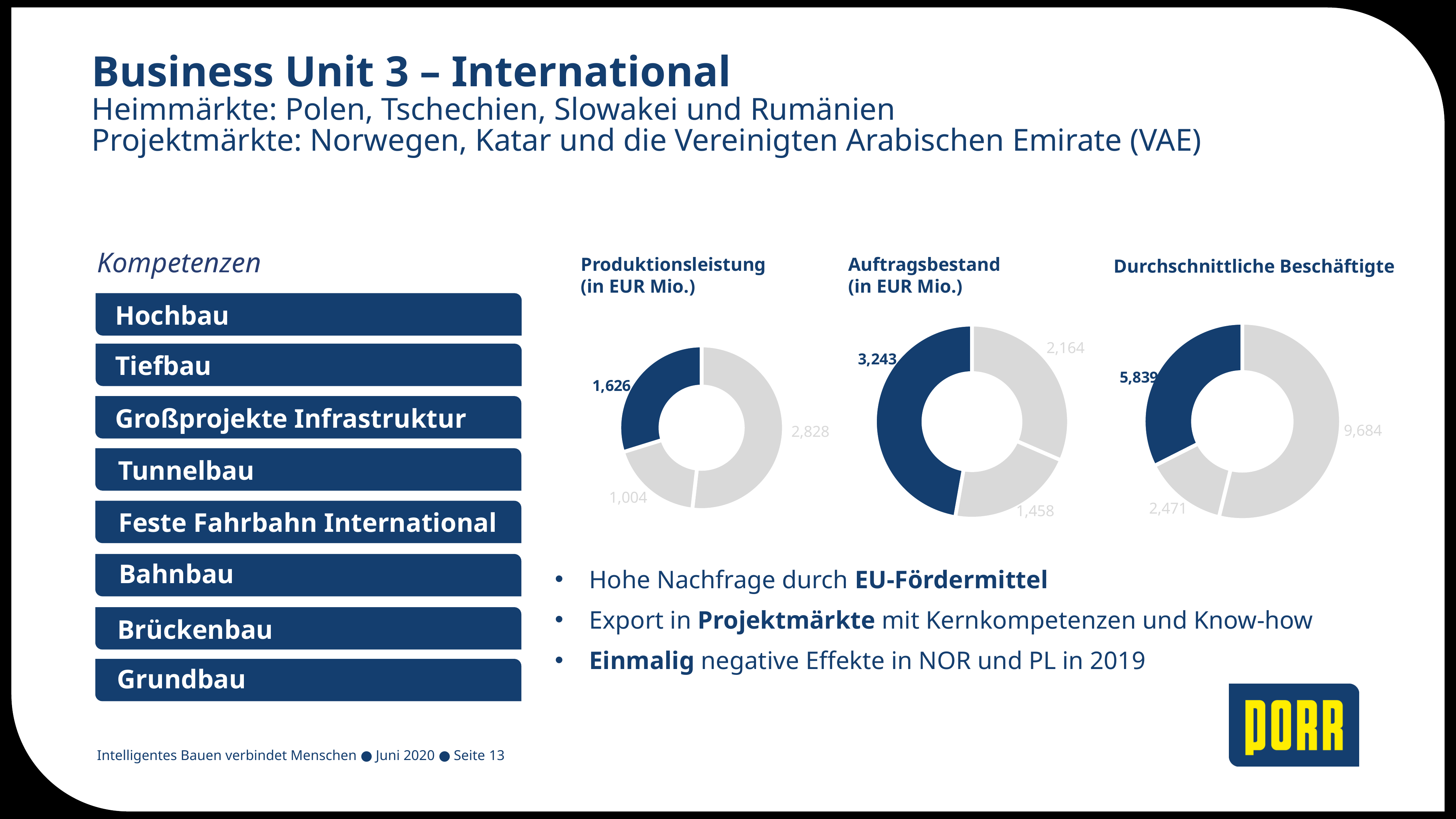
In the Produktionsleistung (in EUR Mio.) chart, what is the largest slice value? 2,828 How many donut charts are shown on the slide? 3 What kind of chart is used for Produktionsleistung (in EUR Mio.)? Donut (pie) chart In the Durchschnittliche Beschäftigte chart, what is the value of the dark blue slice? 5,839 In the Auftragsbestand (in EUR Mio.) chart, what is the value of the dark blue slice? 3,243 In the Auftragsbestand (in EUR Mio.) chart, what is the difference between the dark blue slice (3,243) and the slice labelled 2,164? 1,079 What is the total of all slices in the Produktionsleistung (in EUR Mio.) chart? 5,458 In the Produktionsleistung (in EUR Mio.) chart, which is larger: the dark blue slice or the slice labelled 1,004? The dark blue slice (1,626) In the Durchschnittliche Beschäftigte chart, what is the smallest slice value? 2,471 In the Produktionsleistung (in EUR Mio.) chart, what is the value of the dark blue slice? 1,626 What is the total of all slices in the Durchschnittliche Beschäftigte chart? 17,994 How many slices does the Auftragsbestand (in EUR Mio.) chart have? 3